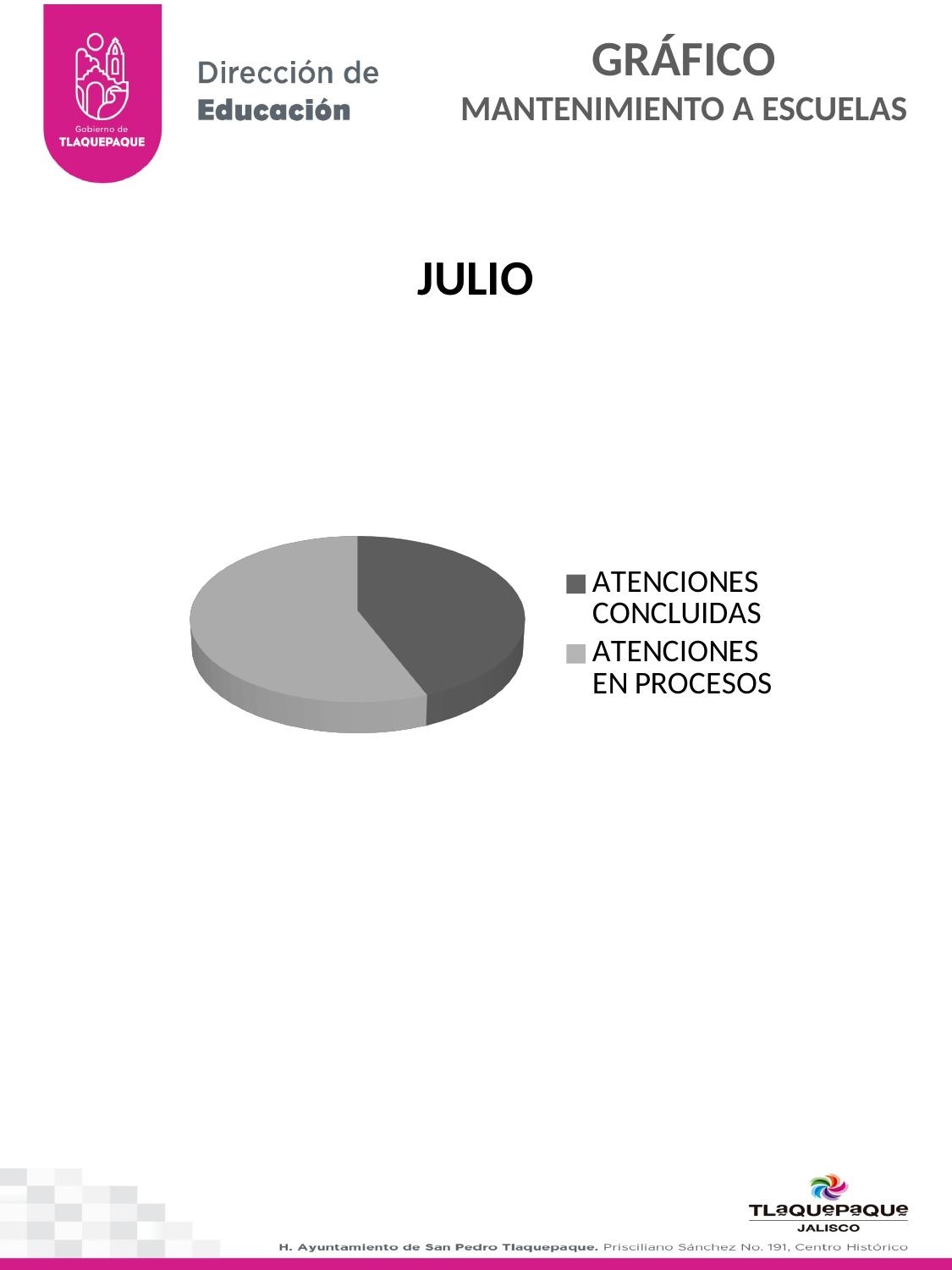
How many slices does the pie chart have? 2 Which category has the smallest slice of the pie? ATENCIONES CONCLUIDAS Which slice is larger, ATENCIONES CONCLUIDAS or ATENCIONES EN PROCESOS? ATENCIONES EN PROCESOS What kind of chart is shown on the slide? Pie chart What is the title of the chart? JULIO How many entries does the legend list? 2 Which category has the largest slice of the pie? ATENCIONES EN PROCESOS Which legend entry is shown in the darker gray colour? ATENCIONES CONCLUIDAS